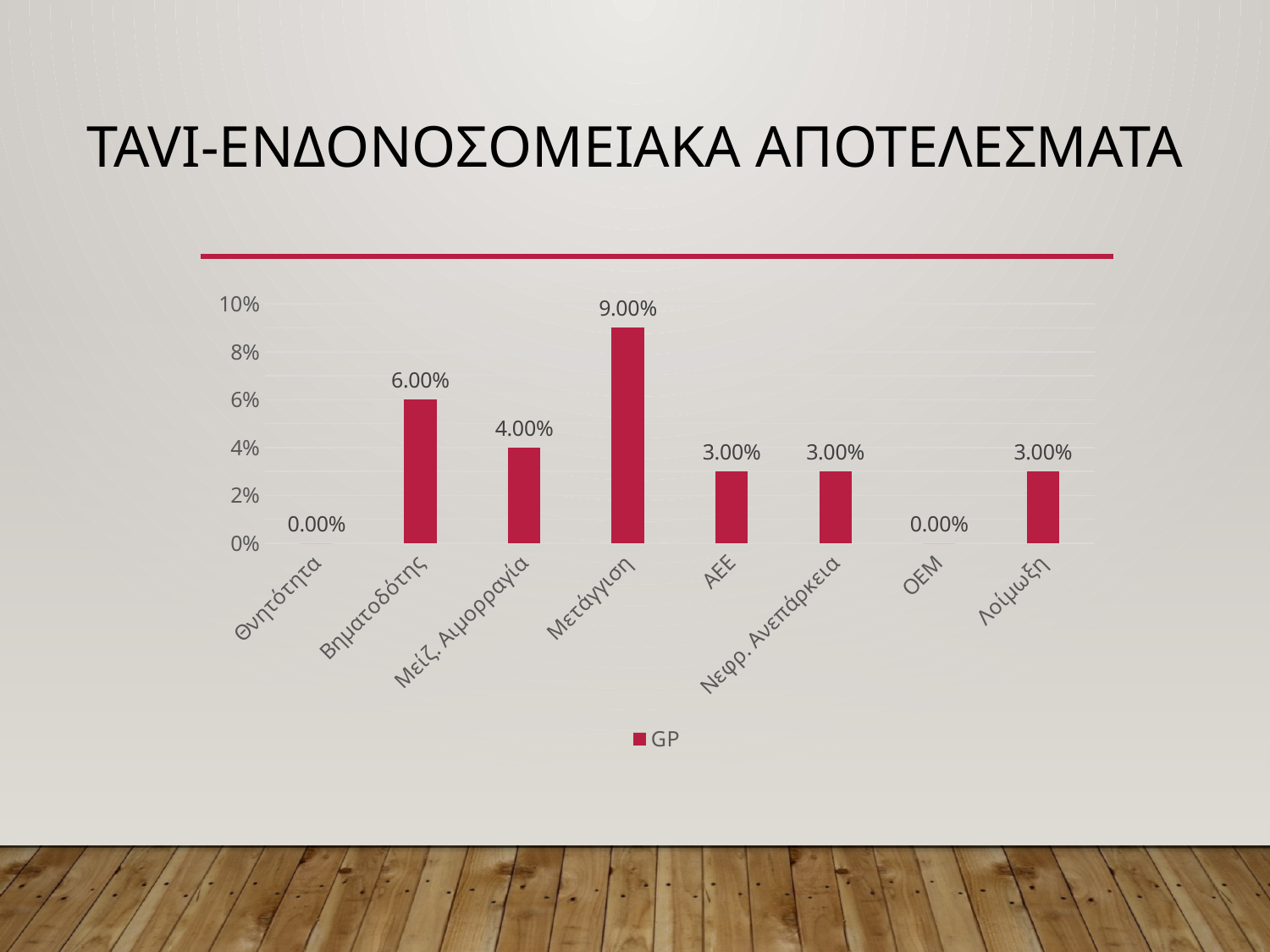
What is the value for Μετάγγιση? 9.00% How many categories are shown on the x axis? 8 How many series does the legend list? 1 What is the value for Βηματοδότης? 6.00% What is the name of the series shown in the legend? GP Which is larger, the value for Βηματοδότης or the value for ΑΕΕ? Βηματοδότης Is the value for Μετάγγιση greater or less than 8%? greater Which category has the highest value? Μετάγγιση What kind of chart is shown on the slide? bar chart What is the value for Λοίμωξη? 3.00% What is the value for Μείζ. Αιμορραγία? 4.00% What is the difference between the values for Μετάγγιση and Βηματοδότης? 3.00%